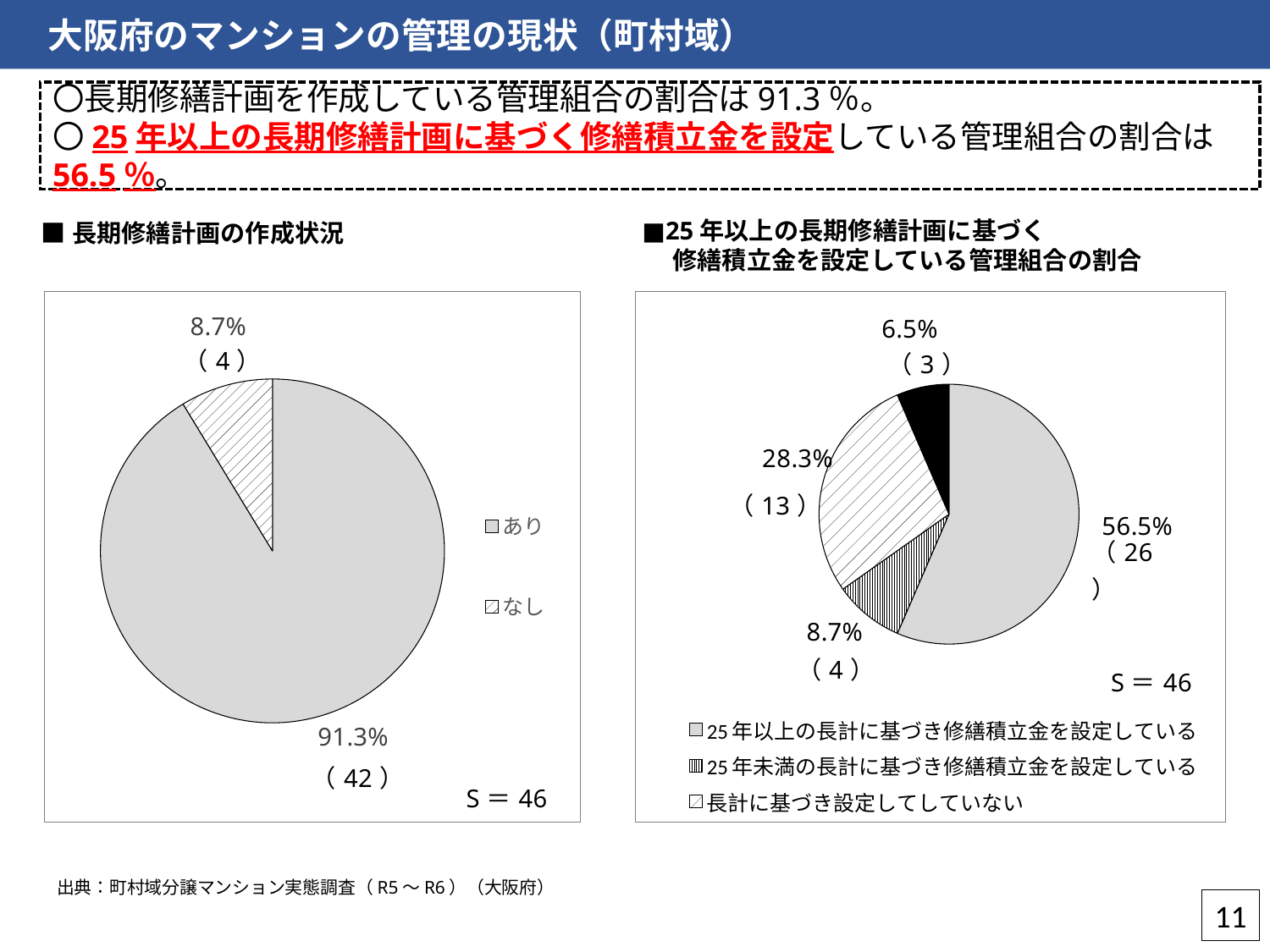
右の円グラフ「25年以上の長期修繕計画に基づく修繕積立金を設定している管理組合の割合」で、「25年以上の長計に基づき修繕積立金を設定している」と「長計に基づき設定していない」では、どちらの割合が大きいですか？ 25年以上の長計に基づき修繕積立金を設定している 右の円グラフ「25年以上の長期修繕計画に基づく修繕積立金を設定している管理組合の割合」で、最も割合が小さい区分の割合は何%ですか？ 6.5% このスライドの2つのグラフはどの種類のグラフですか？ 円グラフ 右の円グラフ「25年以上の長期修繕計画に基づく修繕積立金を設定している管理組合の割合」で、「長計に基づき設定していない」の件数はいくつですか？ 13 右の円グラフ「25年以上の長期修繕計画に基づく修繕積立金を設定している管理組合の割合」で、「25年以上の長計に基づき修繕積立金を設定している」の割合は何%ですか？ 56.5% 左の円グラフ「長期修繕計画の作成状況」で、「あり」と「なし」の割合の差は何ポイントですか？ 82.6ポイント 左の円グラフ「長期修繕計画の作成状況」で、「なし」の件数はいくつですか？ 4 右の円グラフ「25年以上の長期修繕計画に基づく修繕積立金を設定している管理組合の割合」で、「25年未満の長計に基づき修繕積立金を設定している」の割合は何%ですか？ 8.7% 左の円グラフ「長期修繕計画の作成状況」のサンプル数（S）はいくつですか？ 46 左の円グラフ「長期修繕計画の作成状況」で、最も割合が大きい区分はどれですか？ あり 左の円グラフ「長期修繕計画の作成状況」で、「あり」の割合は何%ですか？ 91.3% 左の円グラフ「長期修繕計画の作成状況」の凡例には、いくつの区分が示されていますか？ 2